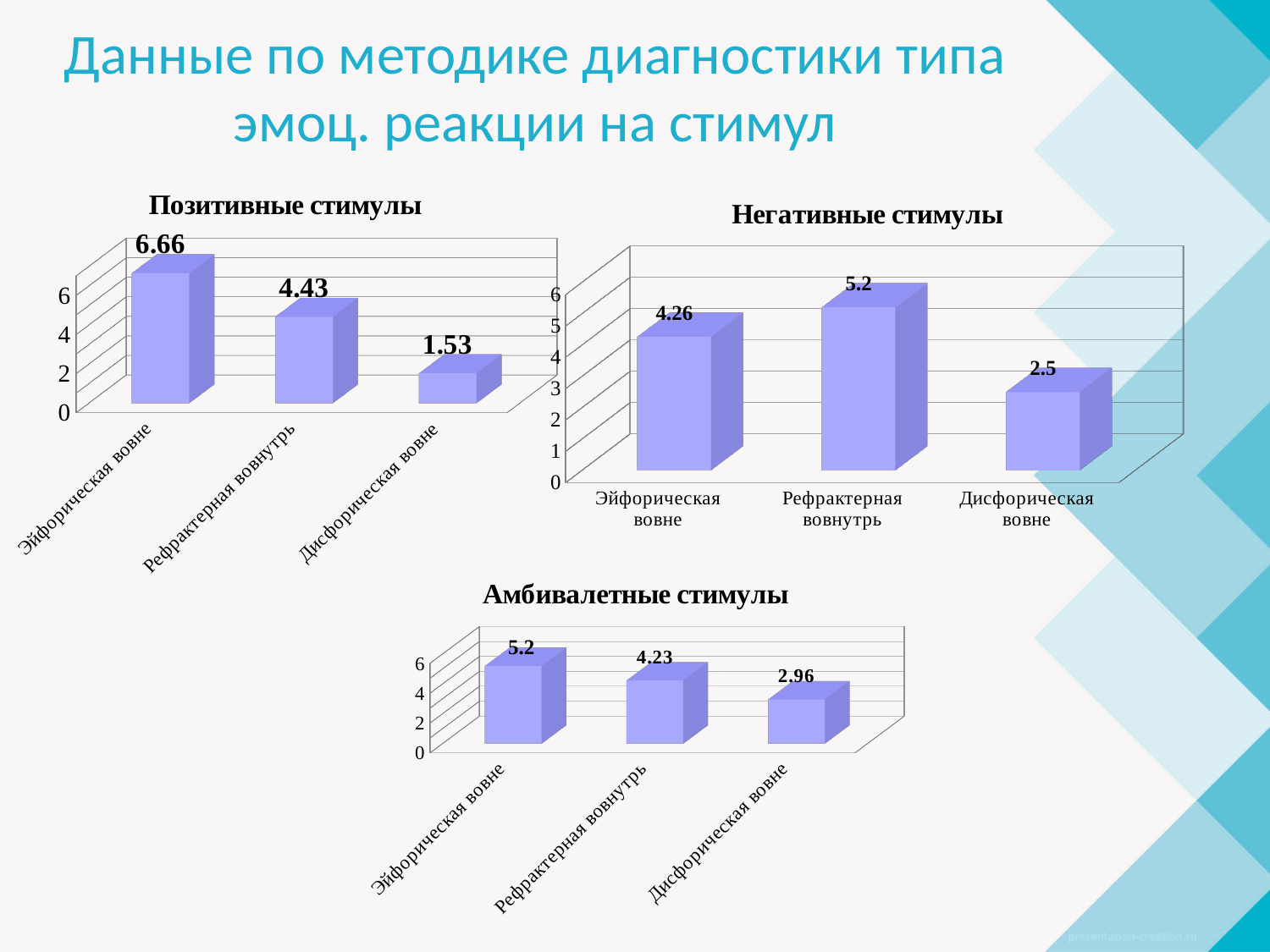
In the 'Позитивные стимулы' chart, do the values rise or fall from left to right? Fall In the 'Амбивалетные стимулы' chart, which is larger: 'Эйфорическая вовне' or 'Рефрактерная вовнутрь'? Эйфорическая вовне In the 'Позитивные стимулы' chart, what is the value for 'Эйфорическая вовне'? 6.66 In the 'Амбивалетные стимулы' chart, what is the value for 'Дисфорическая вовне'? 2.96 In the 'Позитивные стимулы' chart, what is the difference between 'Эйфорическая вовне' and 'Рефрактерная вовнутрь'? 2.23 In the 'Негативные стимулы' chart, is the value for 'Эйфорическая вовне' greater or less than 4? greater How many categories are shown in the 'Амбивалетные стимулы' chart? 3 In the 'Негативные стимулы' chart, what is the difference between 'Рефрактерная вовнутрь' and 'Дисфорическая вовне'? 2.7 In the 'Негативные стимулы' chart, which category has the highest value? Рефрактерная вовнутрь In the 'Позитивные стимулы' chart, which category has the lowest value? Дисфорическая вовне In the 'Негативные стимулы' chart, what is the value for 'Рефрактерная вовнутрь'? 5.2 What type of chart is the 'Позитивные стимулы' chart? Bar chart